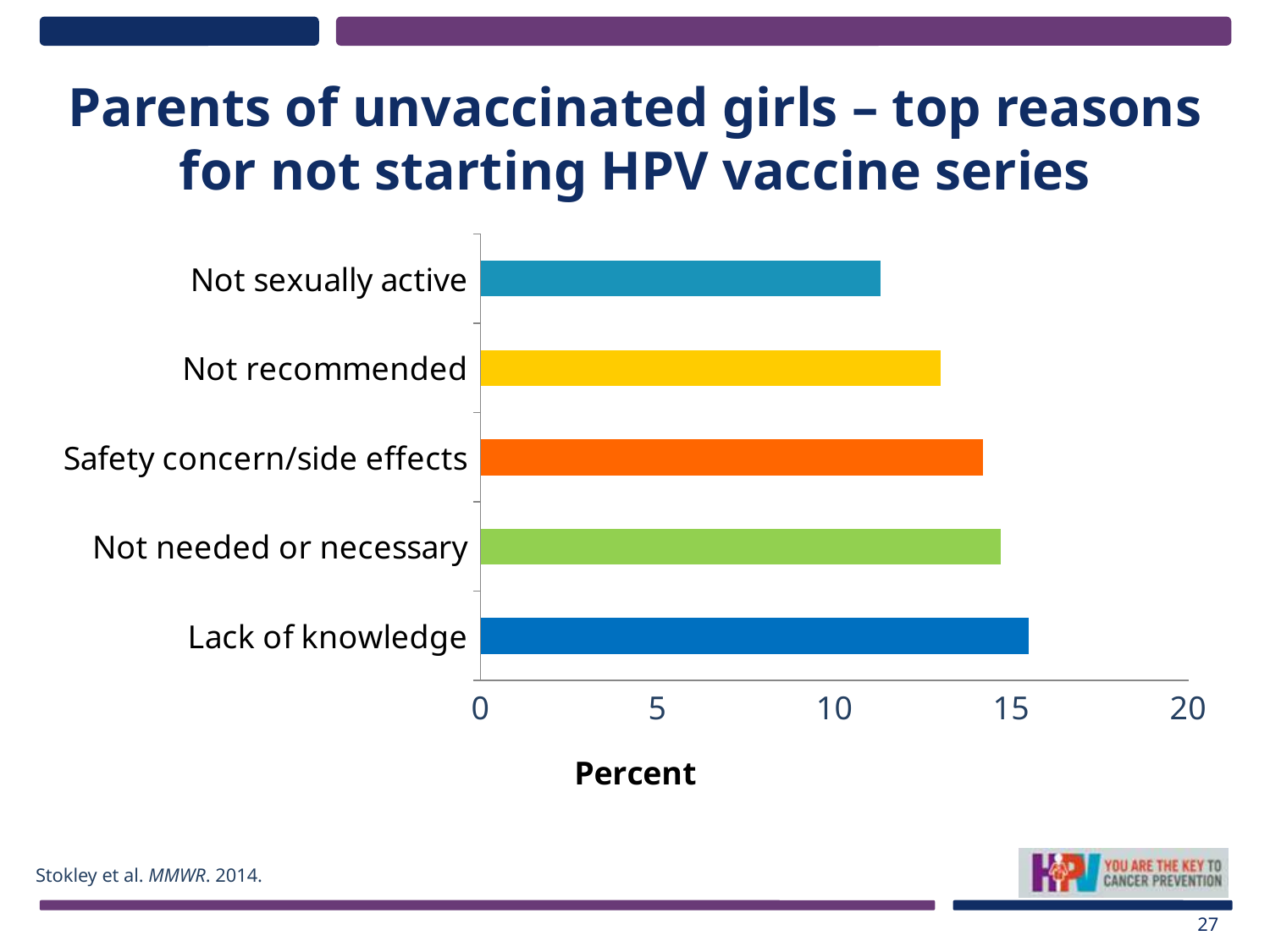
Is the value for Not recommended greater or less than 15? less Is the value for Not sexually active greater or less than 15? less Which is larger, the value for Not recommended or the value for Not sexually active? Not recommended How many reasons (categories) are plotted in the chart? 5 Is the value for Lack of knowledge greater or less than 15? greater What kind of chart is shown on the slide? Bar chart Which reason has the lowest percentage? Not sexually active Which reason has the highest percentage? Lack of knowledge What is the label on the horizontal axis of the chart? Percent Which is larger, the value for Lack of knowledge or the value for Not recommended? Lack of knowledge